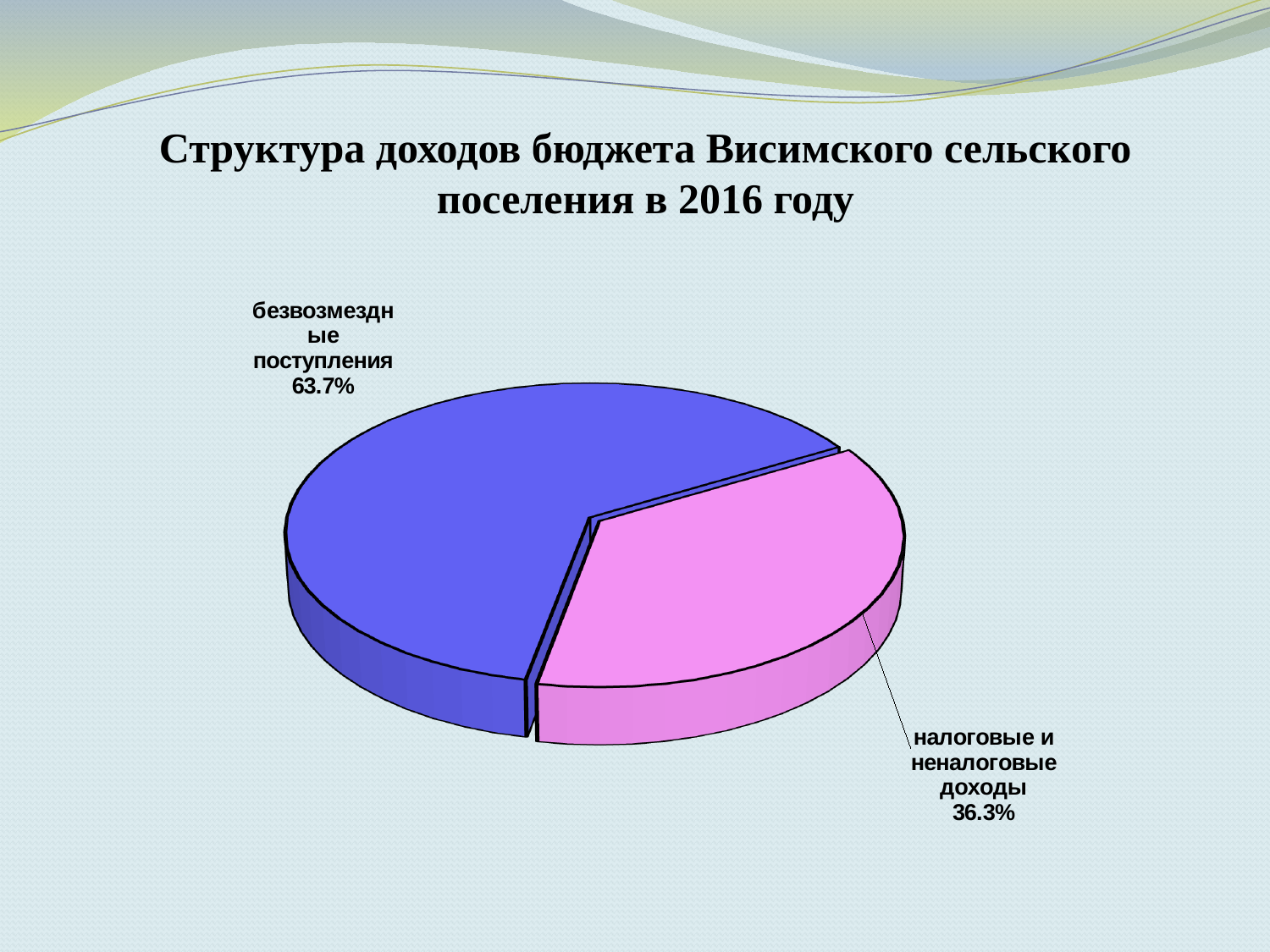
What is the total of the two slice percentages shown on the pie? 100% Which slice of the pie is the smallest? налоговые и неналоговые доходы What share of the pie is labelled "безвозмездные поступления"? 63.7% What colour is the slice for "налоговые и неналоговые доходы"? pink What is the title of the chart on the slide? Структура доходов бюджета Висимского сельского поселения в 2016 году Which is larger: the share for "безвозмездные поступления" or the share for "налоговые и неналоговые доходы"? безвозмездные поступления How many slices does the pie chart have? 2 What is the difference in percentage points between "безвозмездные поступления" and "налоговые и неналоговые доходы"? 27.4 Which slice of the pie is the largest? безвозмездные поступления What kind of chart is shown on the slide? pie chart What share of the pie is labelled "налоговые и неналоговые доходы"? 36.3%